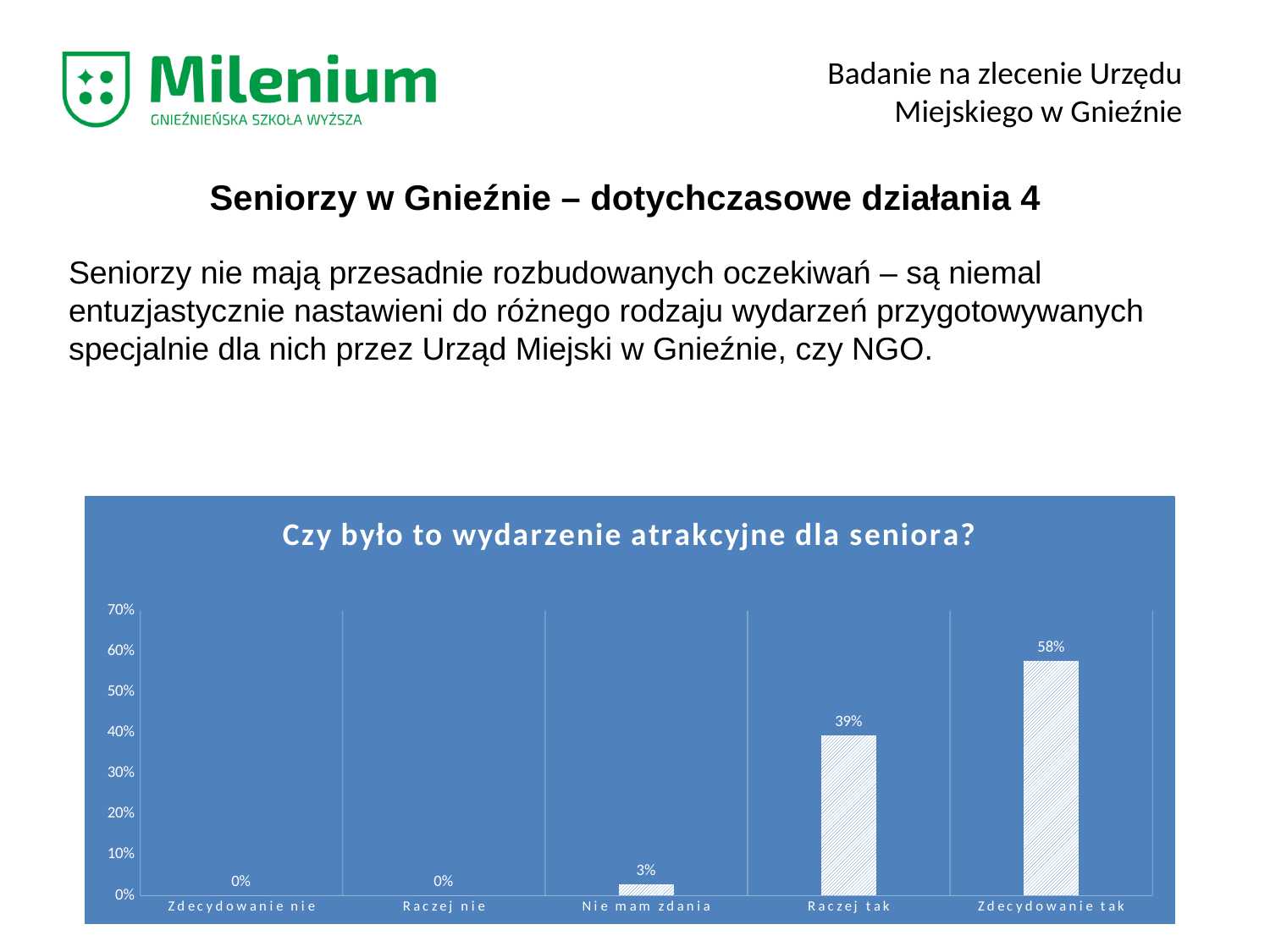
What kind of chart is shown on the slide? bar chart Which category has the highest value? Zdecydowanie tak Which is larger, the value for "Raczej tak" or the value for "Nie mam zdania"? Raczej tak Do the values rise or fall from left to right along the x axis? rise How many categories are shown on the x axis? 5 What is the value for "Zdecydowanie tak"? 58% What is the value for "Raczej tak"? 39% Is the value for "Zdecydowanie tak" greater or less than 50%? greater What is the value for "Nie mam zdania"? 3% What is the difference between the values for "Zdecydowanie tak" and "Raczej tak"? 19% What is the value for "Raczej nie"? 0% What is the title of the chart? Czy było to wydarzenie atrakcyjne dla seniora?